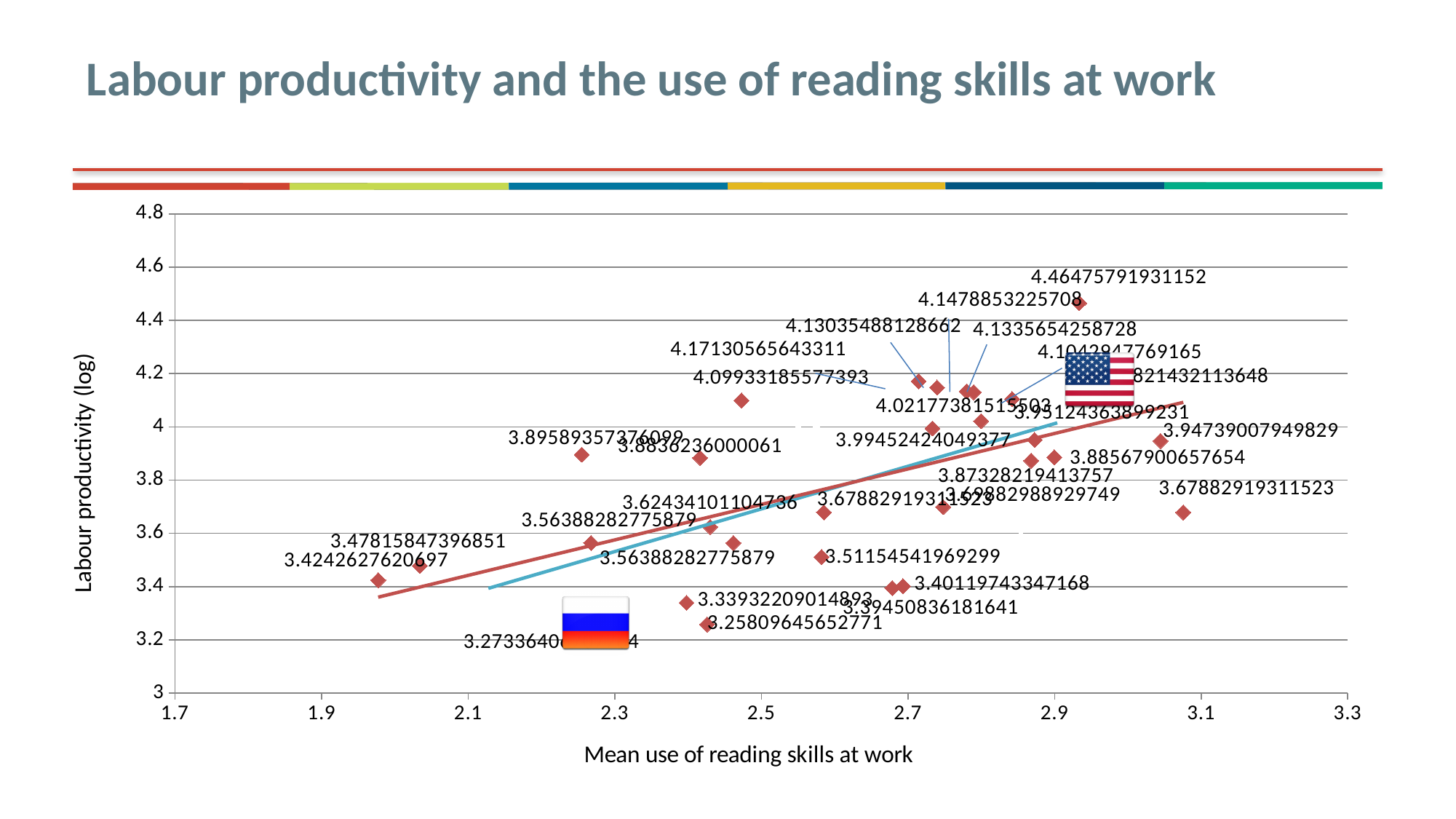
Do labour productivity values generally rise or fall as mean use of reading skills at work increases? rise What is the title of the chart on the slide? Labour productivity and the use of reading skills at work Which is larger: the labelled value of the point near x = 2.93 (4.46475791931152) or the labelled value of the point near x = 1.98 (3.4242627620697)? 4.46475791931152 What is the highest labour productivity value labelled on the chart? 4.46475791931152 What is the label of the x axis of the chart? Mean use of reading skills at work What is the lowest labour productivity value labelled on the chart? 3.25809645652771 What is the difference between the highest labelled value (4.46475791931152) and the lowest labelled value (3.25809645652771)? 1.20666146278381 What kind of chart is shown on the slide? scatter chart Is the labour productivity value of the leftmost point (near x = 1.98) greater or less than 3.6? less Is the labour productivity value of the rightmost point (near x = 3.08) greater or less than 3.8? less Is the labour productivity value of the highest point (near x = 2.93) greater or less than 4.4? greater